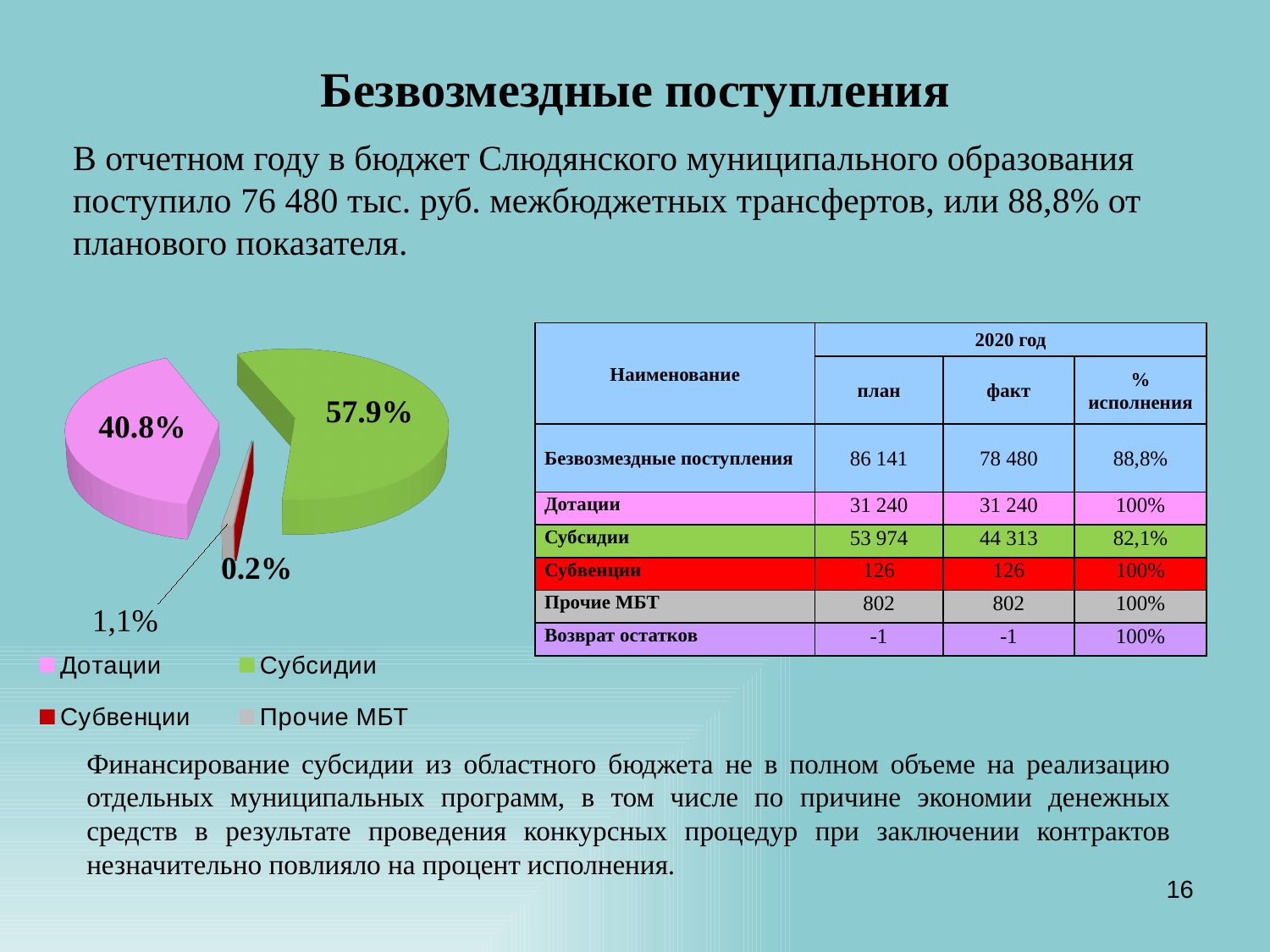
What kind of chart is shown on the slide? pie chart What share of the pie chart does Субсидии have? 57.9% Which slice is larger in the pie chart, Дотации or Субсидии? Субсидии Which category has the largest slice in the pie chart? Субсидии What share of the pie chart does Субвенции have? 0.2% How many entries does the pie chart legend list? 4 What is the difference in percentage points between the Субсидии slice and the Дотации slice? 17.1 What share of the pie chart does Прочие МБТ have? 1,1% What share of the pie chart does Дотации have? 40.8% Which category has the smallest slice in the pie chart? Субвенции Which slice is larger in the pie chart, Прочие МБТ or Субвенции? Прочие МБТ How many slices does the pie chart have? 4